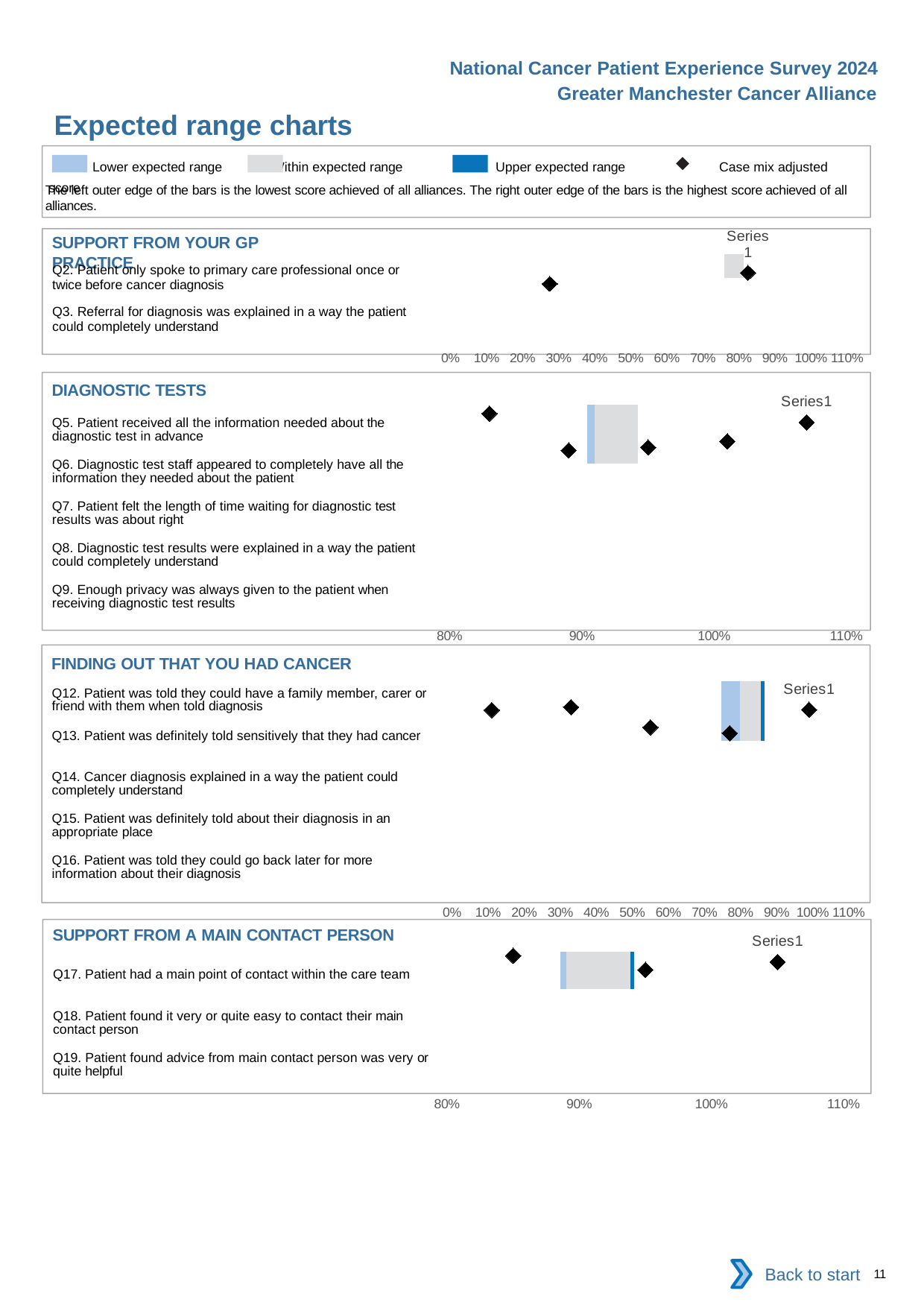
Which survey question is listed first in the 'SUPPORT FROM A MAIN CONTACT PERSON' chart? Q17. Patient had a main point of contact within the care team In the 'DIAGNOSTIC TESTS' chart, what is the lowest value shown on the x axis? 80% How many survey questions are listed in the 'FINDING OUT THAT YOU HAD CANCER' chart? 5 How many survey questions are listed in the 'SUPPORT FROM YOUR GP PRACTICE' chart? 2 In the 'FINDING OUT THAT YOU HAD CANCER' chart, what is the highest value shown on the x axis? 110% How many entries does the legend at the top of the slide list? 4 How many survey questions are listed in the 'DIAGNOSTIC TESTS' chart? 5